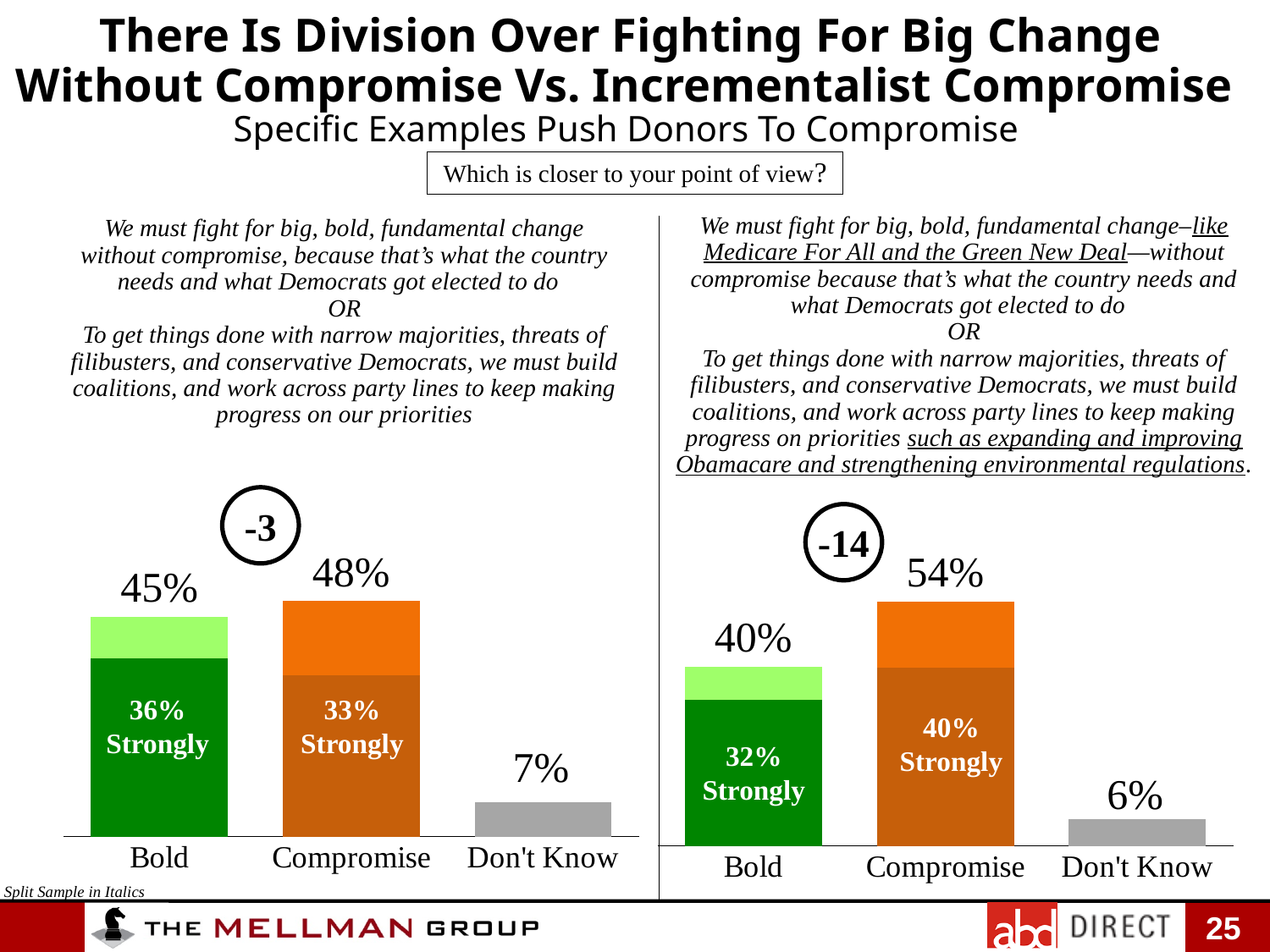
In the right chart, what percentage chose Compromise strongly? 40% In the right chart, which category has the highest total value? Compromise In the left chart, what is the total value for Bold? 45% How many categories are shown on the x axis of the left chart? 3 In the left chart, which is larger, the strongly share for Bold or the strongly share for Compromise? Bold In the right chart, which category has the lowest value? Don't Know In the left chart, what is the total value for Compromise? 48% In the left chart, what is the value for Don't Know? 7% In the right chart, what is the total value for Compromise? 54% In the left chart, what percentage chose Bold strongly? 36% In the right chart, what is the difference between the total for Compromise and the total for Bold? 14% What type of chart is the right chart? Bar chart